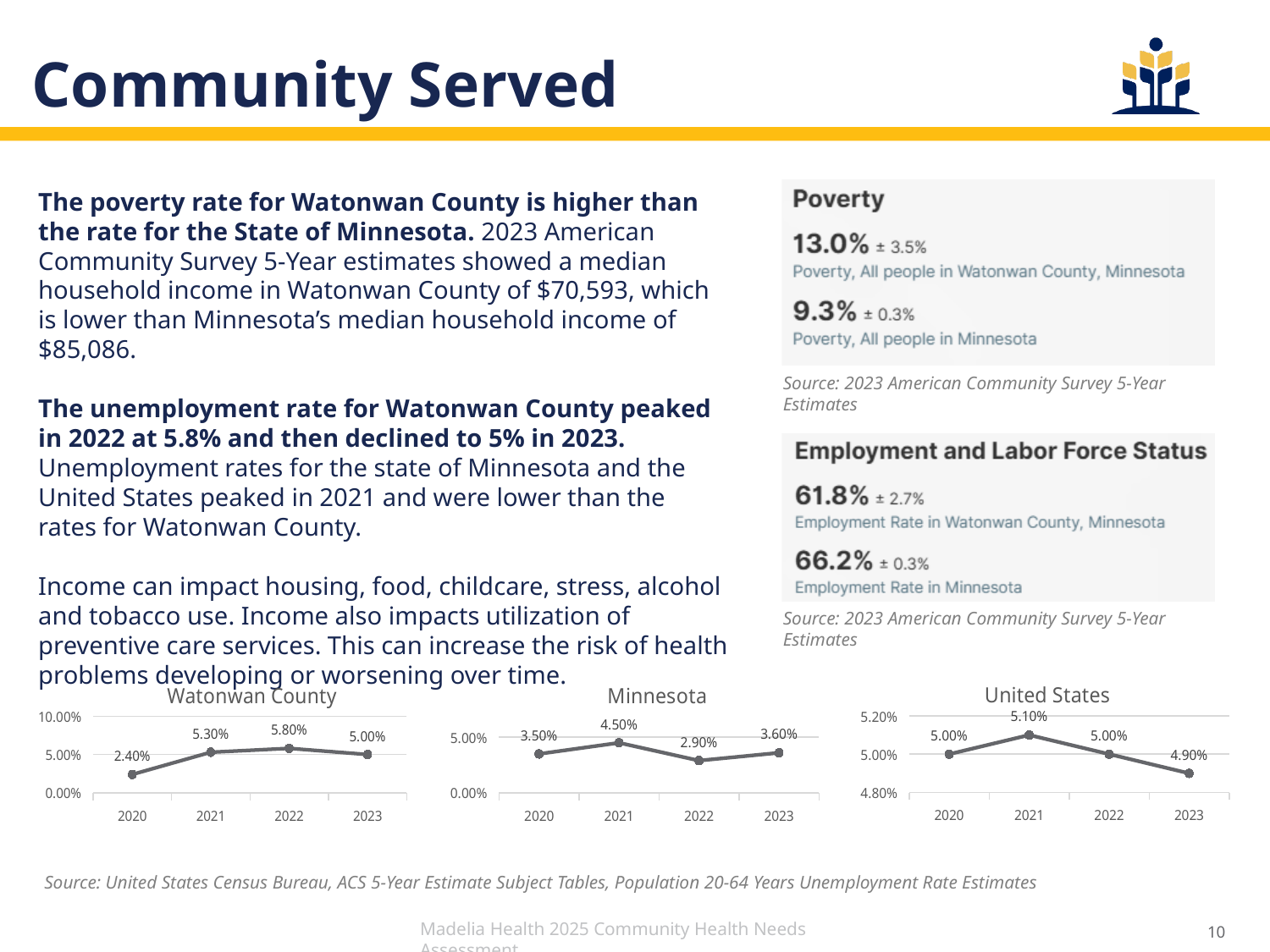
How many data points are plotted in the Minnesota chart? 4 In the Minnesota chart, what is the value for 2021? 4.50% In the United States chart, what is the value for 2023? 4.90% In the Watonwan County chart, which year has the highest value? 2022 In the United States chart, which year has the highest value? 2021 In the Minnesota chart, which year has the lowest value? 2022 In the Watonwan County chart, does the value rise or fall from 2020 to 2021? Rise In the Watonwan County chart, what is the value for 2022? 5.80% In the Watonwan County chart, what is the value for 2020? 2.40% In the Watonwan County chart, what is the difference between the 2022 value and the 2020 value? 3.40% In the Minnesota chart, which is larger, the value for 2021 or the value for 2022? 2021 What kind of chart is the United States chart? Line chart